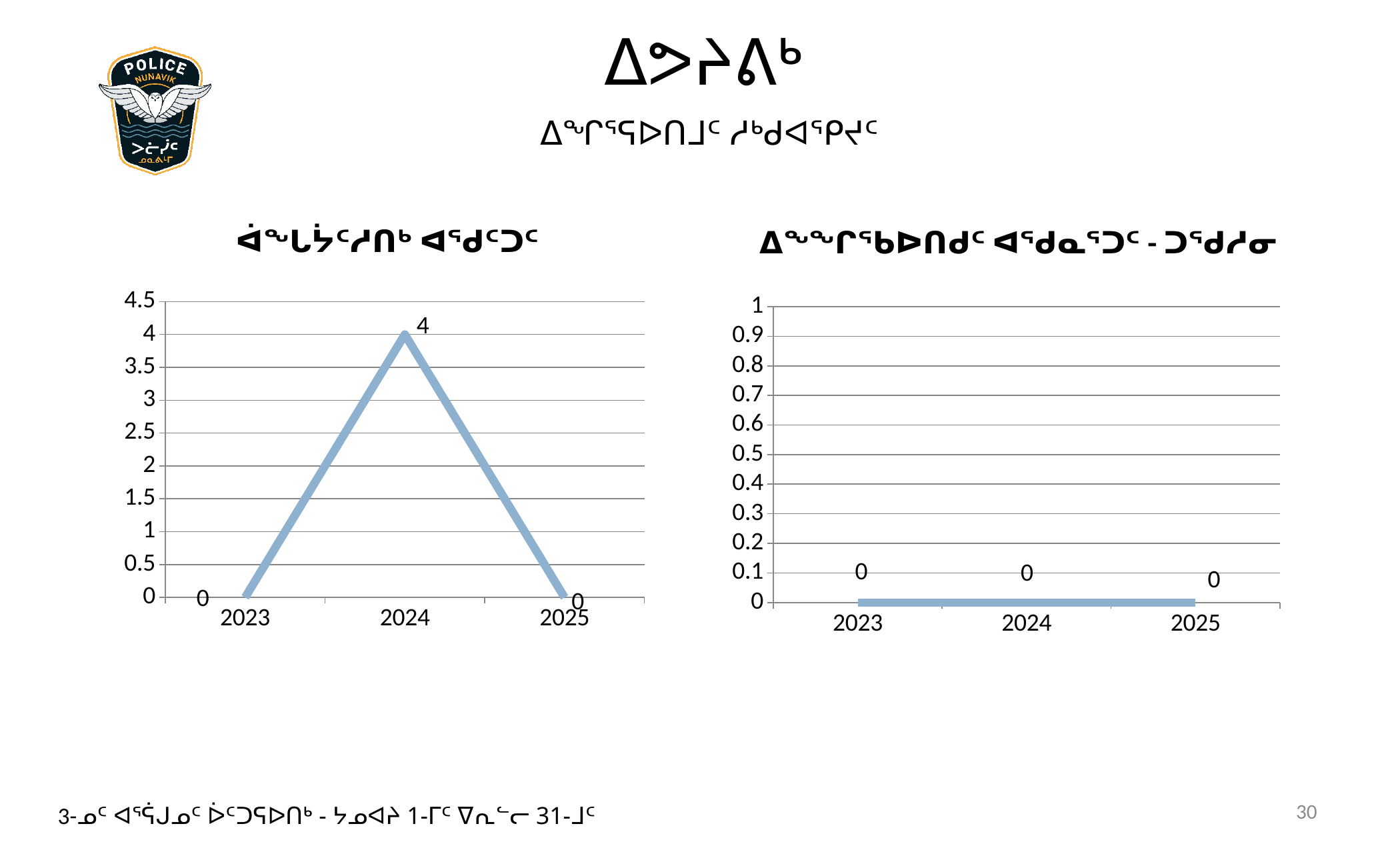
How many years are plotted on the x axis of the left chart? 3 In the right chart, what is the value for 2024? 0 In the left chart, what is the value for 2023? 0 In the left chart, what is the difference between the values for 2024 and 2023? 4 In the left chart, is the value for 2024 greater or less than 3? greater In the right chart, what is the highest value shown on the y axis? 1 In the left chart, does the value rise or fall from 2024 to 2025? fall What kind of chart is the right chart? line chart In the left chart, which year has the highest value? 2024 In the left chart, which is larger, the value for 2024 or the value for 2025? 2024 In the left chart, what is the value for 2025? 0 In the left chart, what is the value for 2024? 4